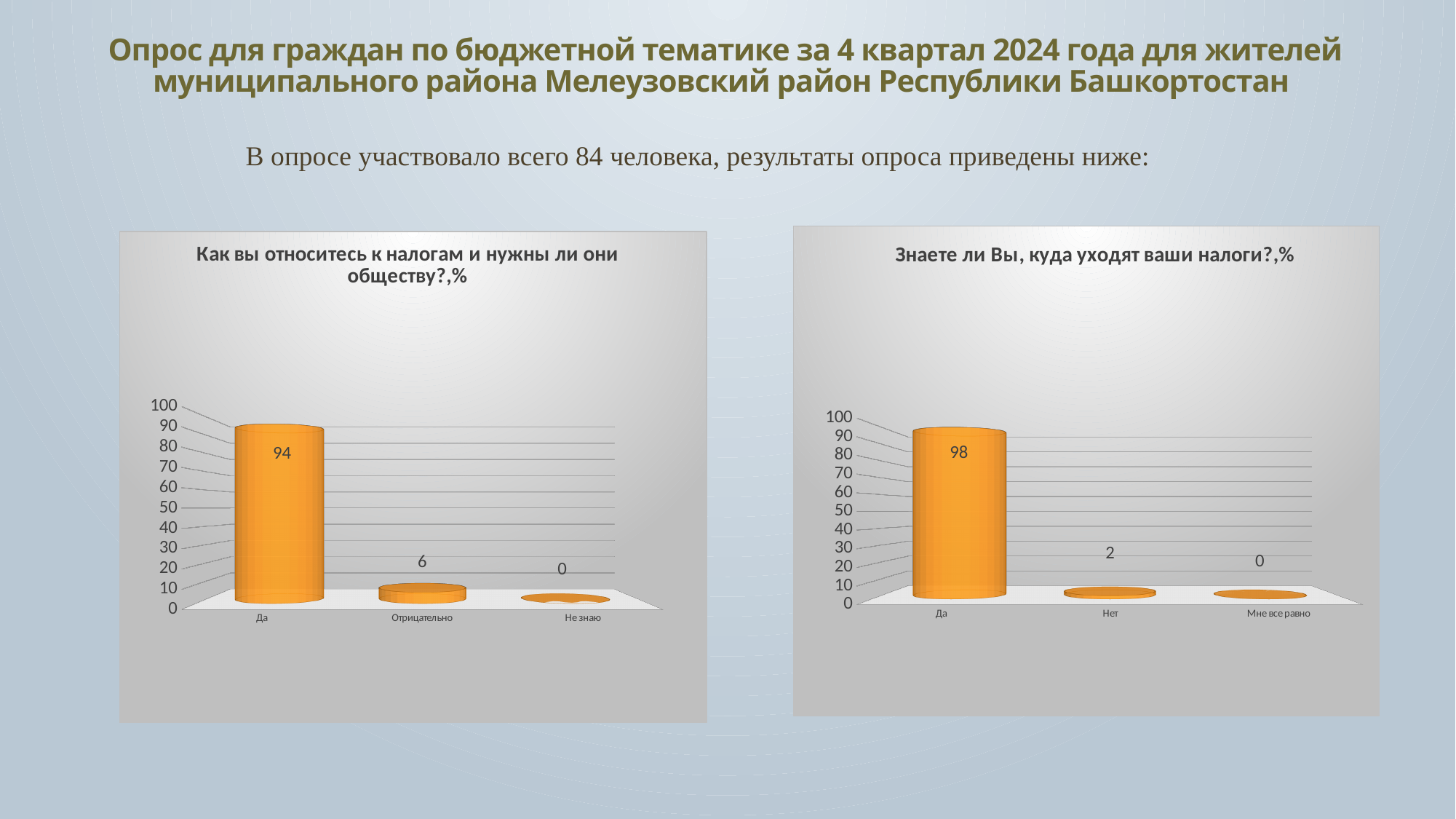
In the right chart 'Знаете ли Вы, куда уходят ваши налоги?,%', what is the difference between the values for 'Да' and 'Нет'? 96 In the left chart 'Как вы относитесь к налогам и нужны ли они обществу?,%', what is the value for 'Да'? 94 In the right chart 'Знаете ли Вы, куда уходят ваши налоги?,%', what is the value for 'Да'? 98 In the right chart 'Знаете ли Вы, куда уходят ваши налоги?,%', how many categories are shown on the x axis? 3 In the left chart 'Как вы относитесь к налогам и нужны ли они обществу?,%', is the value for 'Да' greater or less than 50? greater What type of chart is the left chart 'Как вы относитесь к налогам и нужны ли они обществу?,%'? Bar chart In the right chart 'Знаете ли Вы, куда уходят ваши налоги?,%', what is the value for 'Нет'? 2 In the left chart 'Как вы относитесь к налогам и нужны ли они обществу?,%', what is the difference between the values for 'Да' and 'Отрицательно'? 88 In the left chart 'Как вы относитесь к налогам и нужны ли они обществу?,%', what is the value for 'Не знаю'? 0 In the left chart 'Как вы относитесь к налогам и нужны ли они обществу?,%', which category has the lowest value? Не знаю In the left chart 'Как вы относитесь к налогам и нужны ли они обществу?,%', what is the value for 'Отрицательно'? 6 In the right chart 'Знаете ли Вы, куда уходят ваши налоги?,%', which category has the highest value? Да